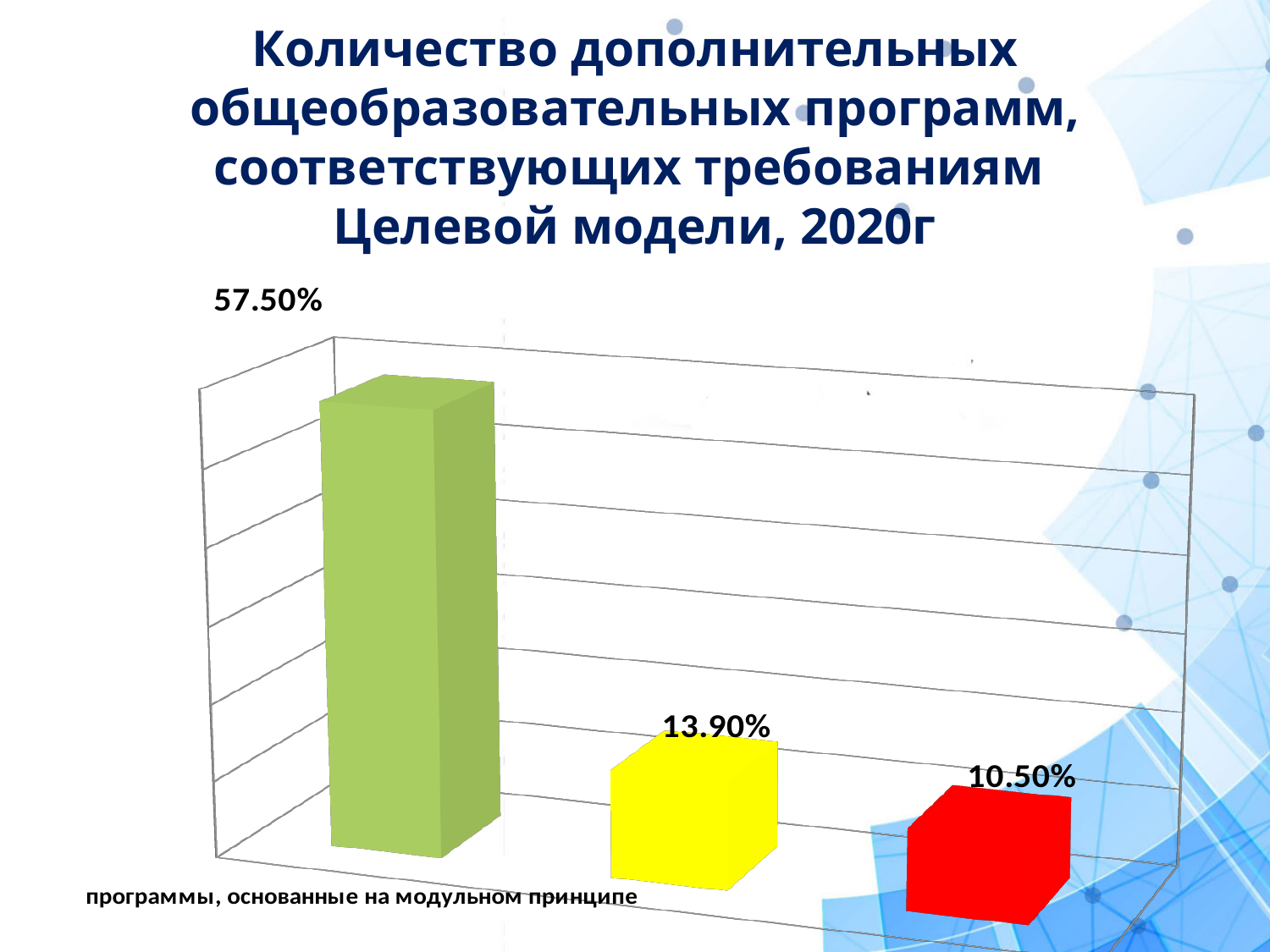
How many bars are plotted in the chart? 3 Which is larger, the value of the yellow bar or the value of the red bar? The yellow bar (13.90%) What is the title of the slide? Количество дополнительных общеобразовательных программ, соответствующих требованиям Целевой модели, 2020г What value is shown on the red bar on the right of the chart? 10.50% What kind of chart is shown on the slide? A 3D bar chart What is the difference between the green bar's value and the yellow bar's value? 43.60% What value is shown for the green bar labelled "программы, основанные на модульном принципе"? 57.50% Which bar has the lowest value? The red bar, 10.50% What value is shown on the yellow bar in the middle of the chart? 13.90% Do the bar values rise or fall from left to right across the chart? Fall What is the difference between the yellow bar's value and the red bar's value? 3.40% Which bar has the highest value? The green bar (программы, основанные на модульном принципе), 57.50%